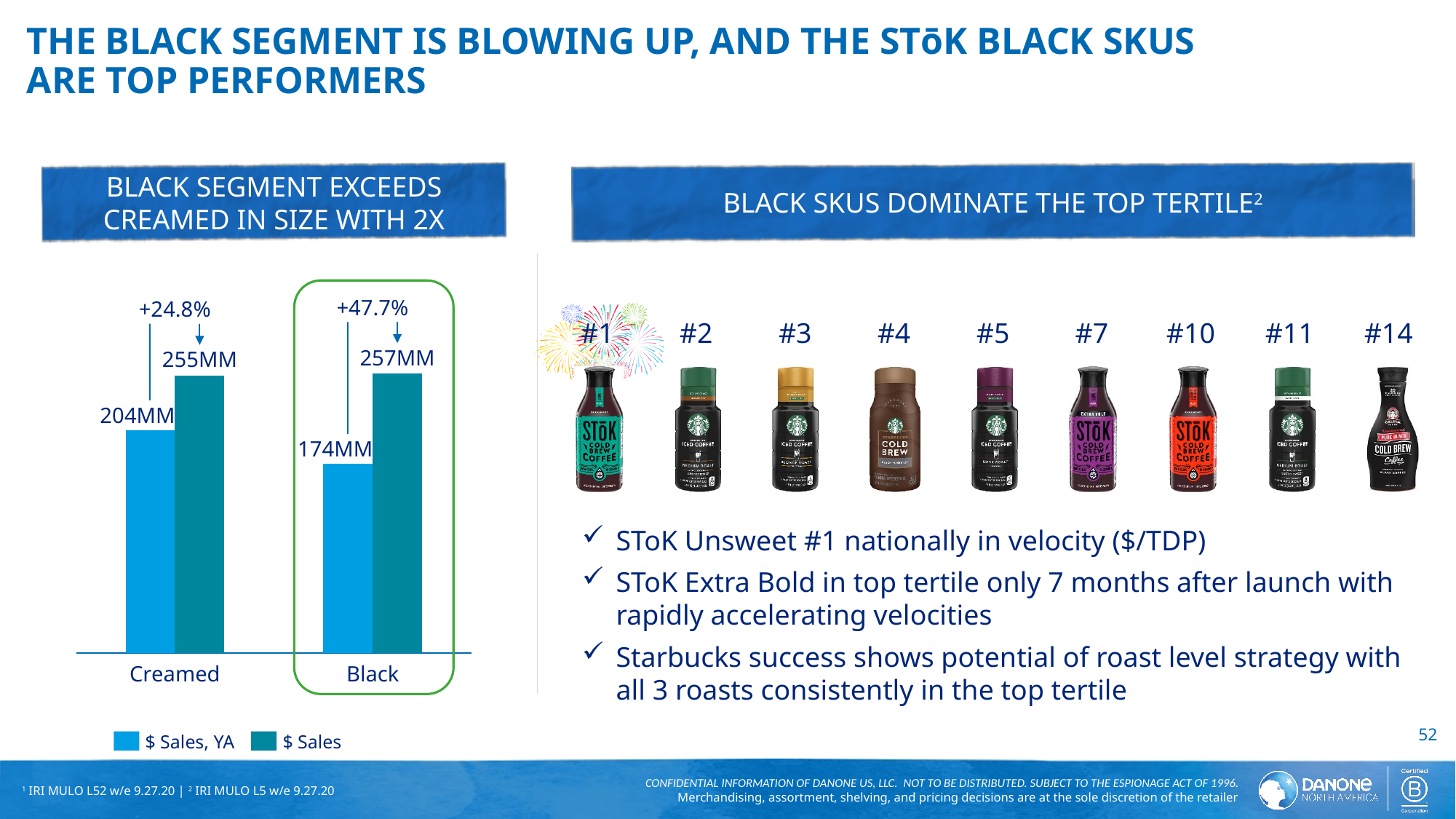
What is the $ Sales, YA value for Black? 174MM What growth percentage is shown above the Creamed bars? +24.8% What growth percentage is shown above the Black bars? +47.7% What is the $ Sales, YA value for Creamed? 204MM What is the $ Sales value for Creamed? 255MM Which is larger: the $ Sales, YA value for Creamed or for Black? Creamed What is the difference between the $ Sales and $ Sales, YA values for Black? 83MM How many series does the chart legend list? 2 What is the $ Sales value for Black? 257MM What type of chart is shown on the slide? Bar chart What is the difference between the $ Sales, YA values for Creamed and Black? 30MM Which category has the lower $ Sales, YA value? Black